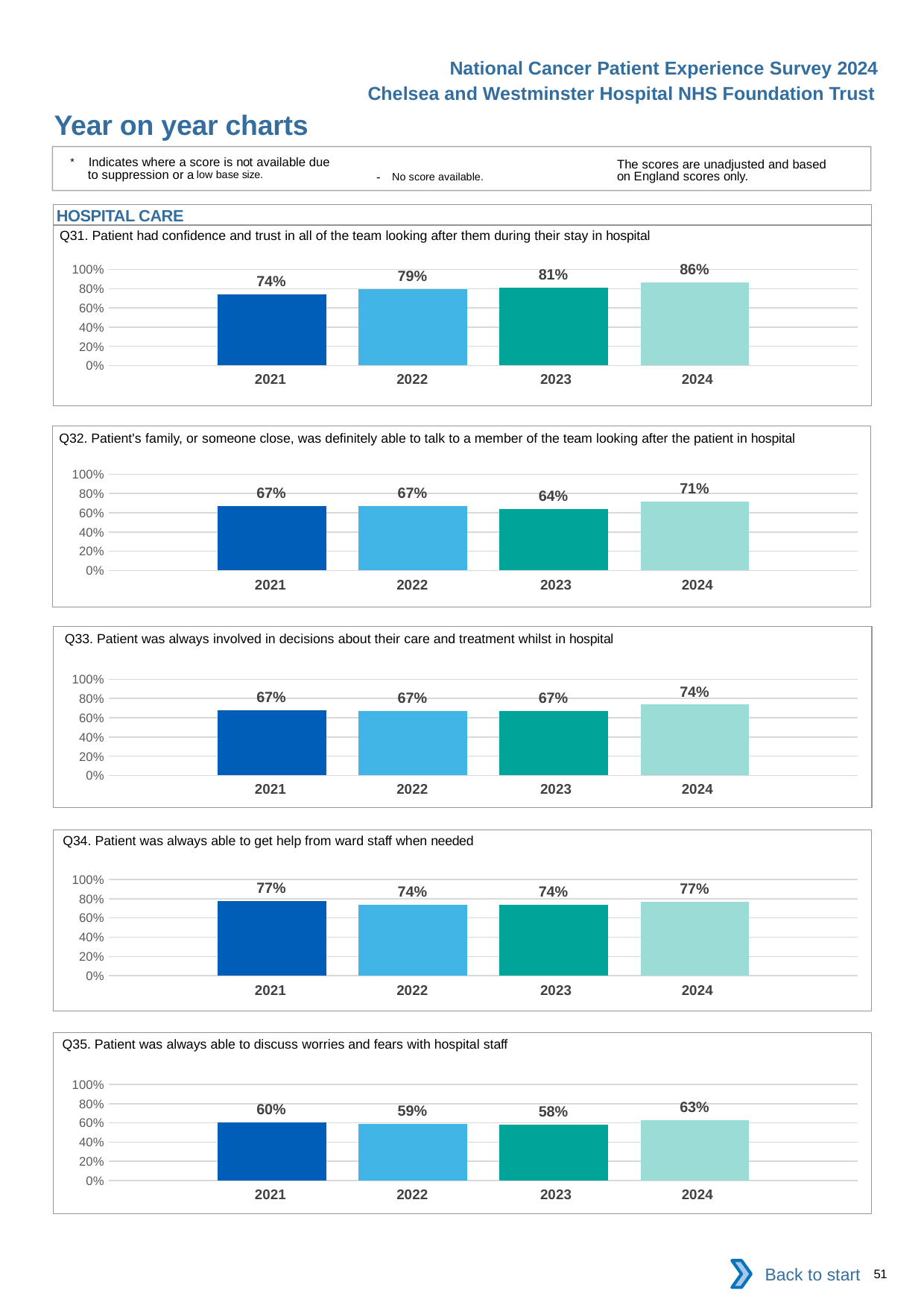
In the Q35 chart (patient was always able to discuss worries and fears), what is the value for 2023? 58% In the Q32 chart, what is the difference between the 2024 and 2023 values? 7% In the Q31 chart, which year has the lowest value? 2021 In the Q33 chart, what is the value for 2022? 67% In the Q34 chart (patient was always able to get help from ward staff), what is the value for 2021? 77% In the Q31 chart, do the values rise or fall from 2021 to 2024? rise In the Q31 chart (patient had confidence and trust in all of the team), what is the value for 2024? 86% In the Q35 chart, how many years are shown on the x axis? 4 What type of chart is used for Q35? bar chart In the Q34 chart, which is larger, the value for 2021 or the value for 2022? 2021 In the Q33 chart (patient was always involved in decisions), which year has the highest value? 2024 In the Q32 chart (patient's family was able to talk to a member of the team), what is the value for 2023? 64%